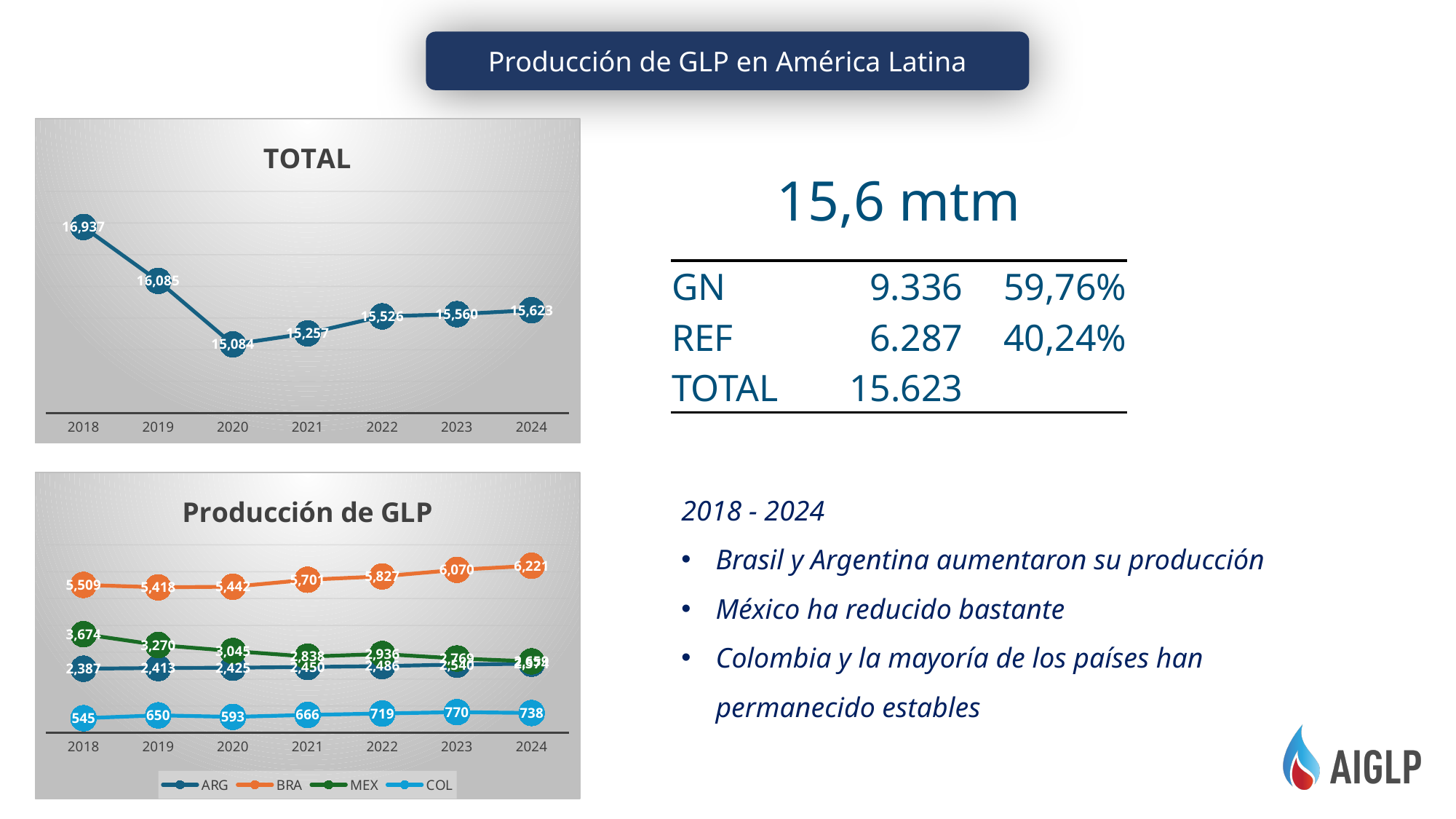
In the Producción de GLP chart, how many series does the legend list? 4 In the Producción de GLP chart, what is the value for BRA in 2024? 6,221 In the TOTAL chart, what is the value for 2018? 16,937 In the Producción de GLP chart, what is the value for COL in 2023? 770 In the TOTAL chart, what is the difference between the 2018 value and the 2020 value? 1,853 In the TOTAL chart, which year has the lowest value? 2020 What kind of chart is the TOTAL chart? Line chart In the TOTAL chart, how many data points are plotted? 7 In the Producción de GLP chart, does the MEX series rise or fall from 2018 to 2023? Fall In the Producción de GLP chart, which is larger in 2019: MEX or ARG? MEX In the Producción de GLP chart, what is the difference between the BRA value in 2023 and the BRA value in 2018? 561 In the Producción de GLP chart, which series has the highest values across all years? BRA